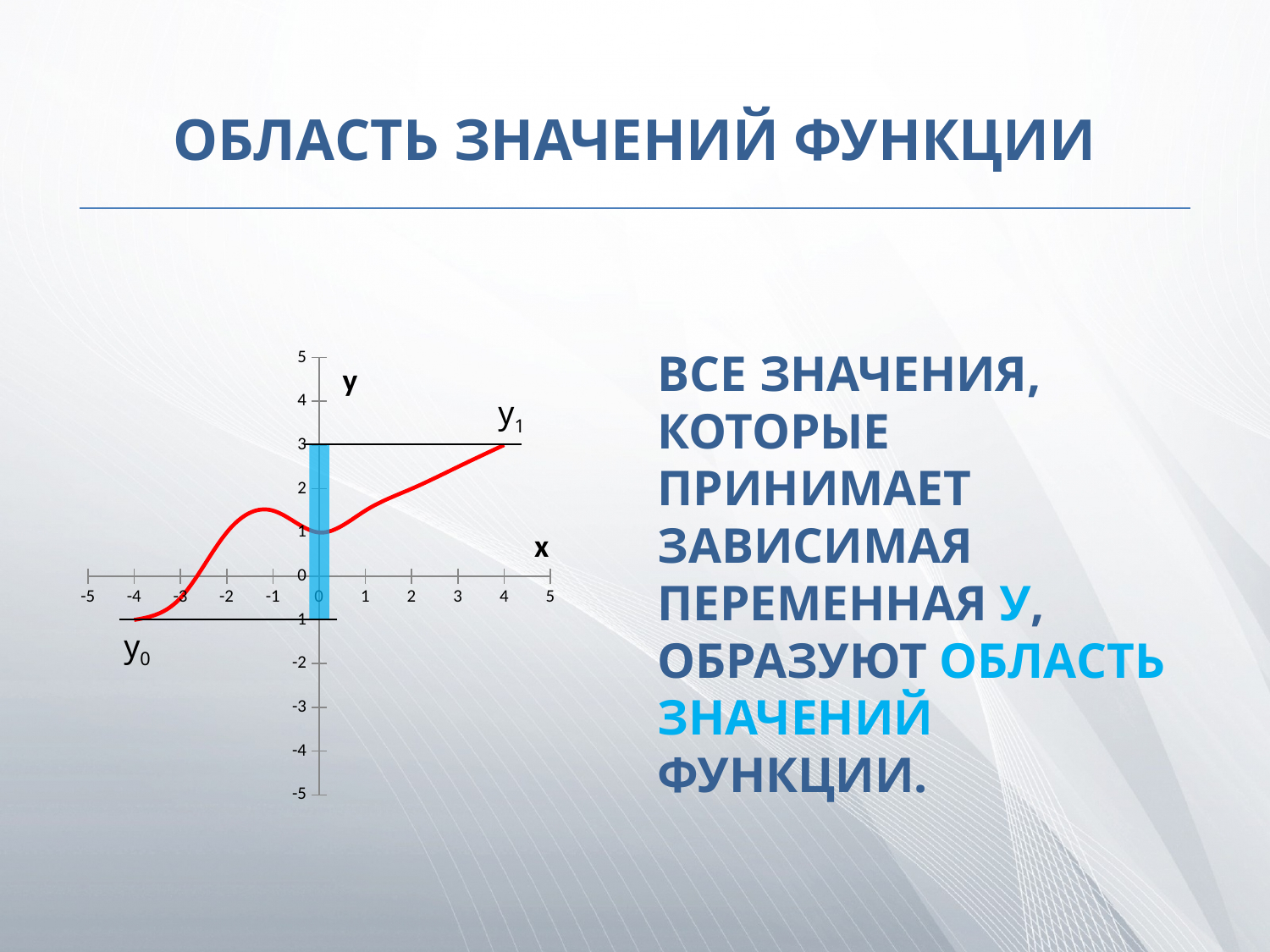
What is the difference between the y1 level (3) and the y0 level (-1)? 4 What is the highest tick value shown on the y axis? 5 What kind of chart is shown on the slide? line chart What is the value of the function at x = 4, where the line labelled y1 meets the curve? 3 What is the value of the function at x = -4, where the line labelled y0 meets the curve? -1 Is the value of the function at x = 2 greater or less than 1? greater Which is larger, the value of the function at x = 4 or at x = -4? x = 4 Is the value of the function at x = -3 greater or less than 0? less What is the lowest tick value shown on the x axis? -5 At which x value does the curve reach its highest point? 4 Is the value of the function at x = -1 greater or less than 2? less Does the curve rise or fall as x goes from 0 to 4? rises